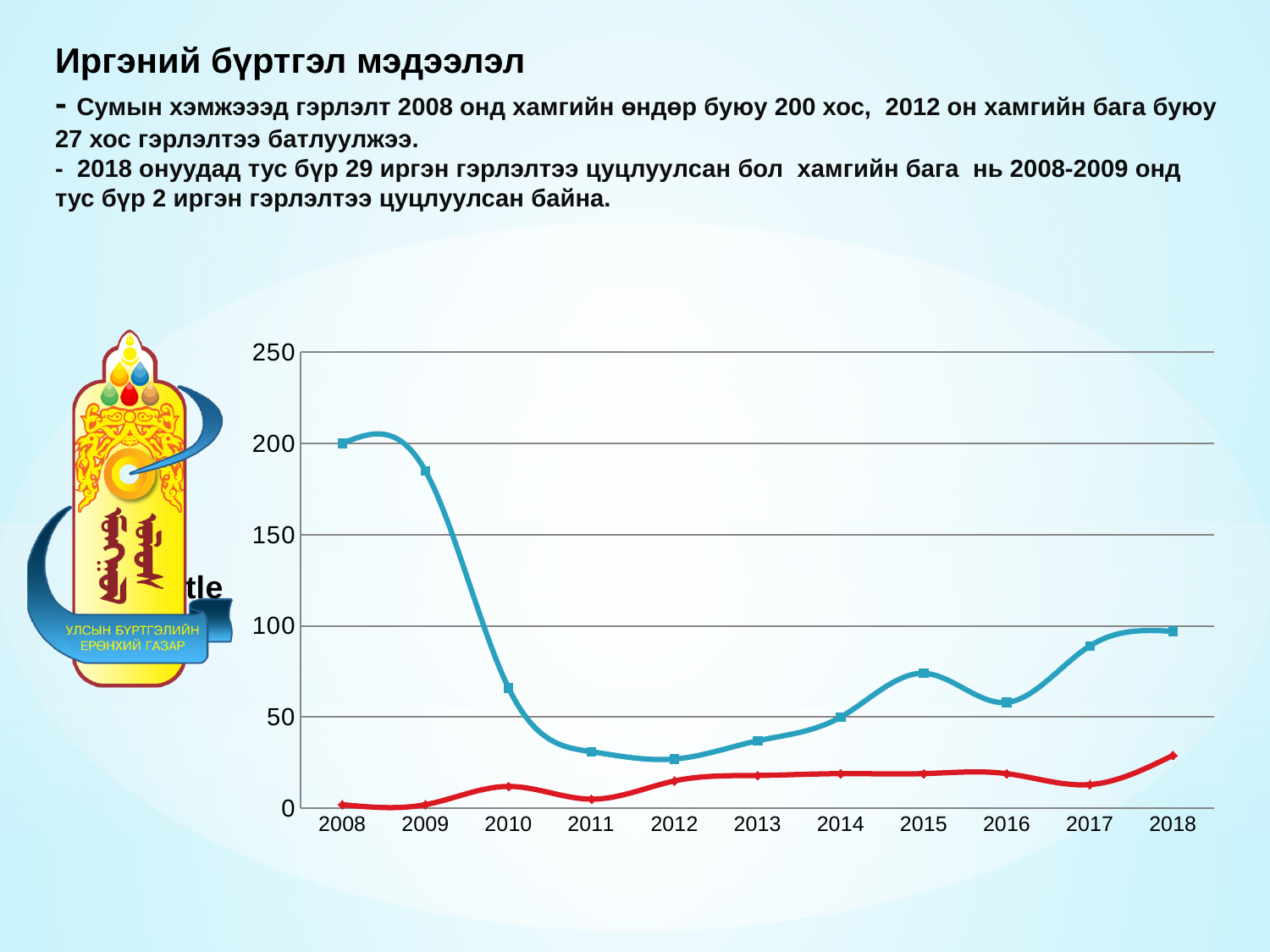
How many years are plotted along the x axis of the chart? 11 What kind of chart is shown on the slide? line chart Is the value of the red line in 2018 greater or less than 50? less Is the value of the blue line in 2009 greater or less than 150? greater What is the highest value shown on the y axis of the chart? 250 Is the value of the blue line in 2015 greater or less than 50? greater Which is larger, the blue line's value in 2009 or its value in 2010? 2009 In which year does the blue line reach its highest value? 2008 In which year does the red line reach its highest value? 2018 What is the value of the blue line in 2008? 200 Does the blue line rise or fall from 2008 to 2012? fall